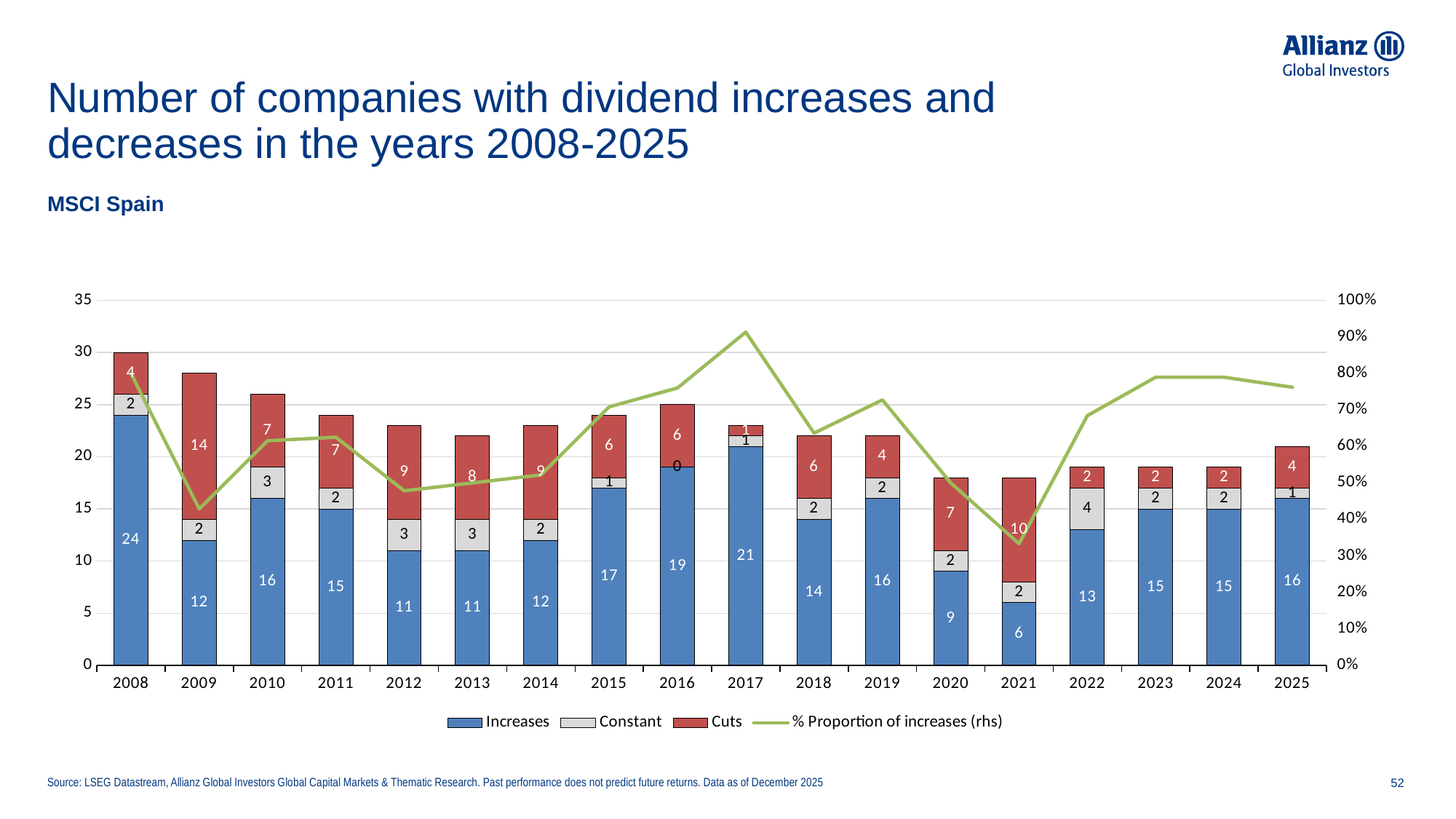
In which year is the Increases value lowest? 2021 What is the total height of the stacked bar for 2008? 30 How many series does the legend list? 4 How many companies had dividend increases in 2017? 21 What is the value for Constant in 2022? 4 Is the % Proportion of increases for 2021 greater or less than 40%? less How many years are shown on the x axis? 18 What is the value for Cuts in 2009? 14 What is the difference between the Increases value in 2008 and in 2009? 12 In which year is the Increases value highest? 2008 Which year has the larger Cuts value, 2020 or 2021? 2021 In which year is the Cuts value highest? 2009